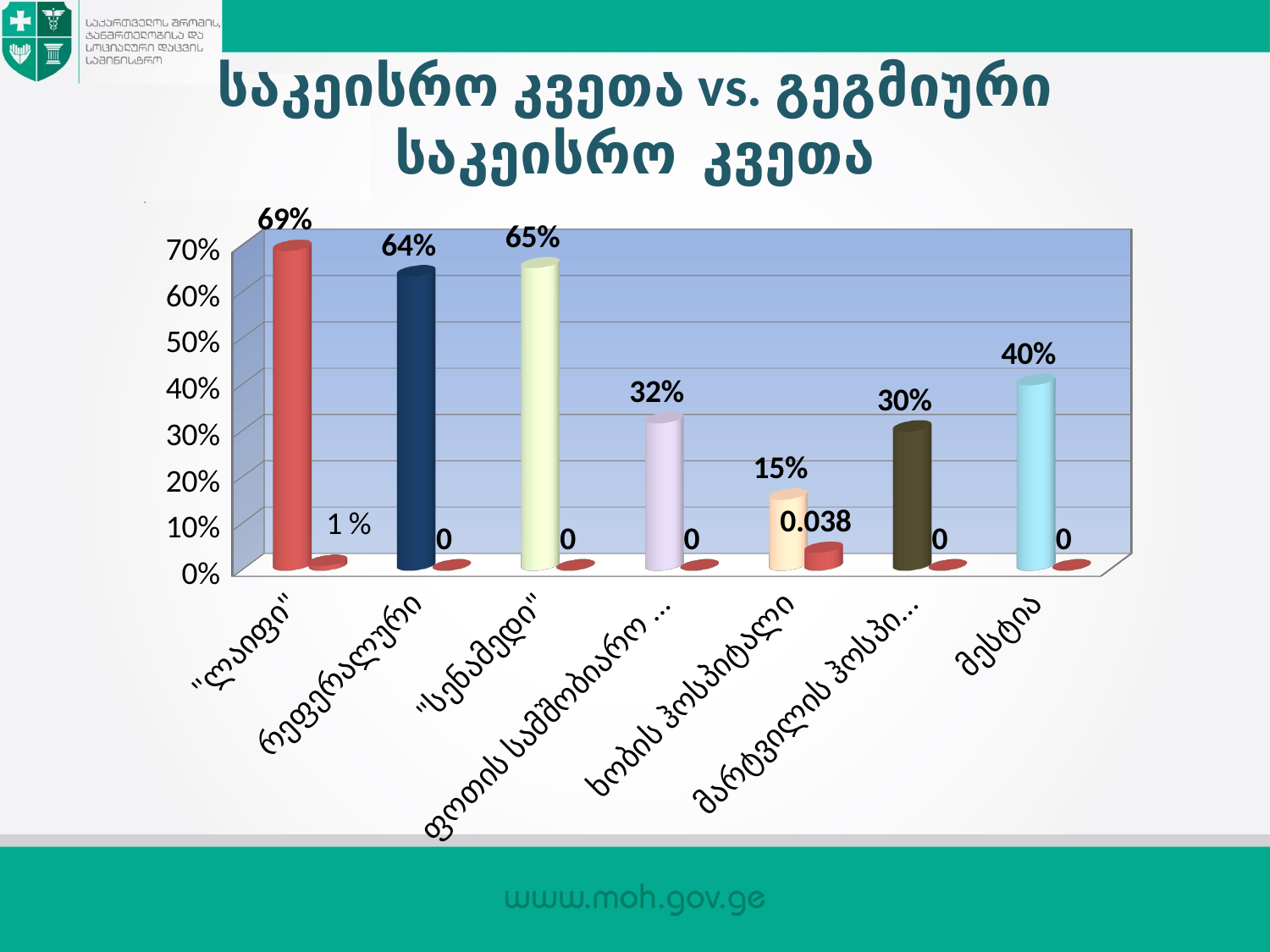
What is the value of the tall bar for რეფერალური? 64% How many categories are shown on the x axis? 7 What is the difference between the tall bar values for "ლაიფი" and რეფერალური? 5% What is the value of the tall bar for ხობის ჰოსპიტალი? 15% What value is labelled on the small red bar for ხობის ჰოსპიტალი? 0.038 What kind of chart is shown on the slide? Bar chart What is the value of the tall bar for "ლაიფი"? 69% What is the value of the tall bar for "სენამედი"? 65% Which category has the highest tall bar? "ლაიფი" Which has a larger tall bar value, "სენამედი" or რეფერალური? "სენამედი" Which category has the lowest tall bar? ხობის ჰოსპიტალი